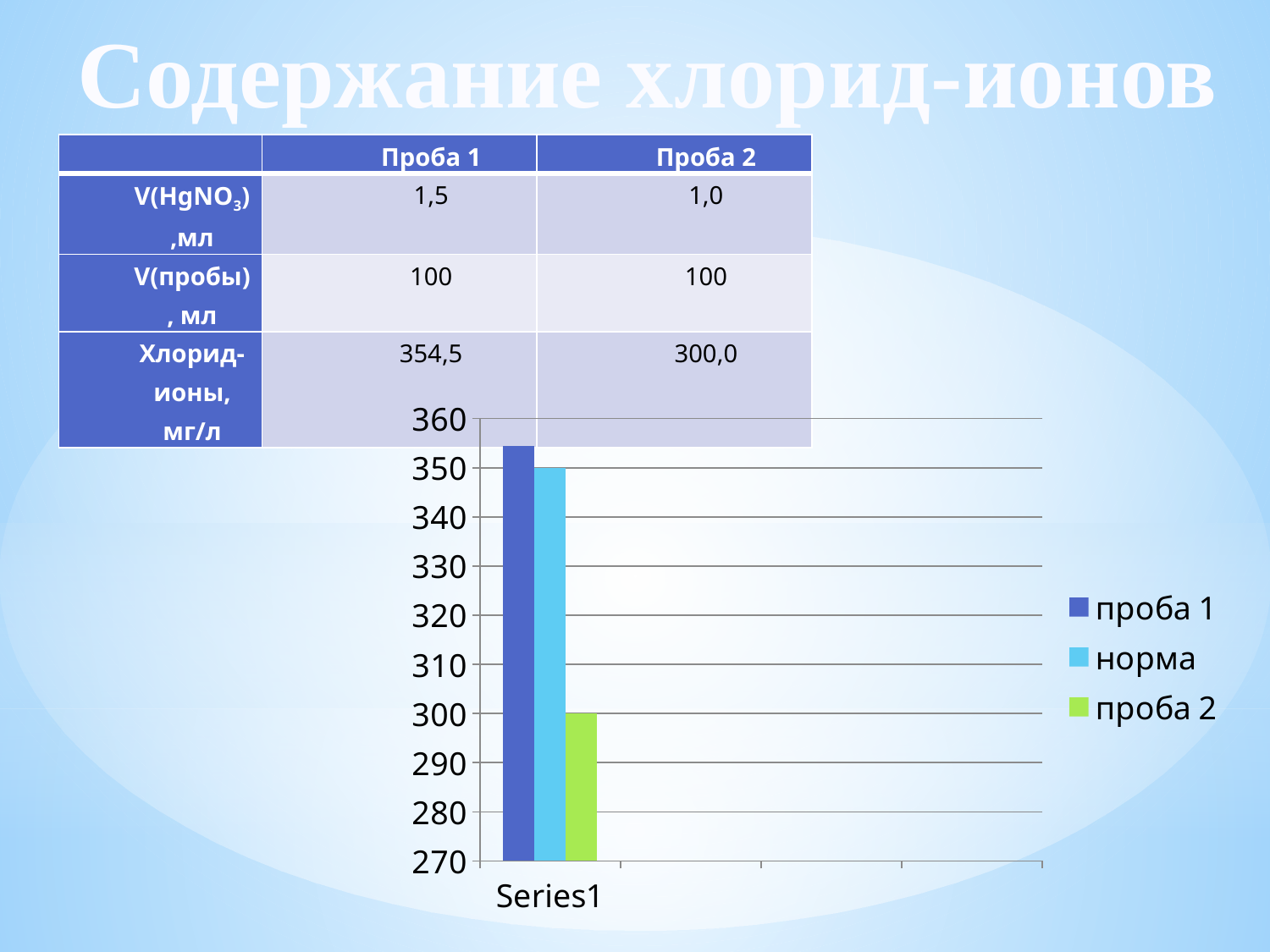
Which series has the highest bar in the chart? проба 1 How many series does the chart legend list? 3 Is the value for проба 2 in the chart greater or less than 320? less What is the difference between the норма bar and the проба 2 bar in the chart? 50 Which series has the lowest bar in the chart? проба 2 Which is larger in the chart, the bar for норма or the bar for проба 2? норма What is the value of the проба 2 bar in the chart? 300 What is the value of the норма bar in the chart? 350 Which is larger in the chart, the bar for проба 1 or the bar for норма? проба 1 What kind of chart is shown on the slide? bar chart Is the value for проба 1 in the chart greater or less than 350? greater What label is shown on the x axis of the chart? Series1